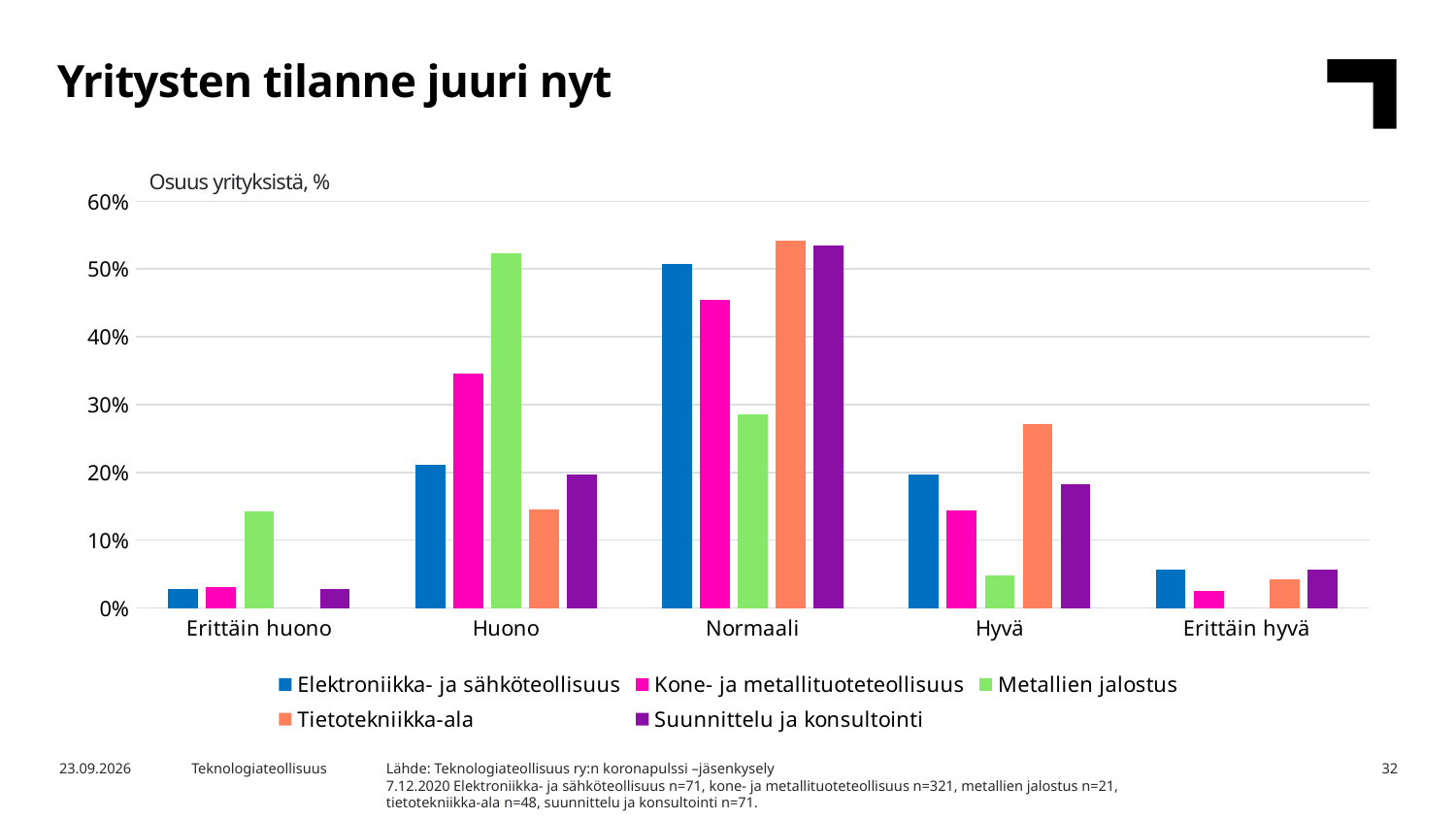
In the Huono category, which is larger: Elektroniikka- ja sähköteollisuus or Tietotekniikka-ala? Elektroniikka- ja sähköteollisuus What kind of chart is shown on the slide? bar chart In the Hyvä category, which series has the highest value? Tietotekniikka-ala In the Huono category, which series has the highest value? Metallien jalostus How many categories are shown on the x axis? 5 Is the value for Tietotekniikka-ala in the Hyvä category greater or less than 20%? greater Is the value for Metallien jalostus in the Huono category greater or less than 50%? greater In the Normaali category, which is larger: Elektroniikka- ja sähköteollisuus or Metallien jalostus? Elektroniikka- ja sähköteollisuus How many series does the legend list? 5 In the Hyvä category, which series has the lowest value? Metallien jalostus What is the label shown above the y axis? Osuus yrityksistä, % Is the value for Kone- ja metallituoteteollisuus in the Huono category greater or less than 30%? greater